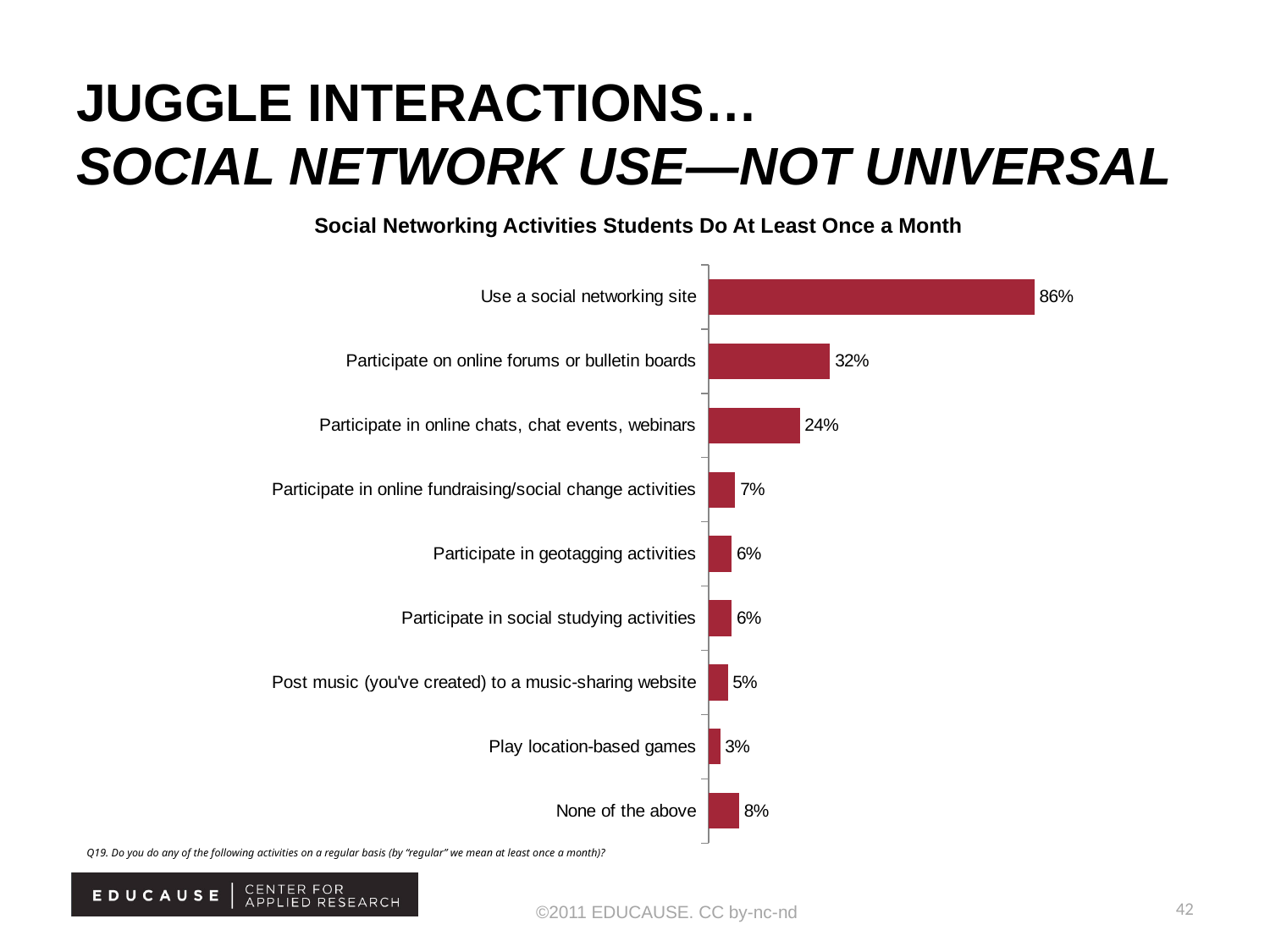
Which activity has the lowest percentage? Play location-based games How many activity categories are shown in the chart? 9 What is the title of the chart? Social Networking Activities Students Do At Least Once a Month Which is larger: 'None of the above' or 'Post music (you've created) to a music-sharing website'? None of the above What percentage of students use a social networking site at least once a month? 86% What percentage of students play location-based games at least once a month? 3% What kind of chart is shown on the slide? Bar chart What is the value for 'None of the above'? 8% What is the difference between 'Participate in online chats, chat events, webinars' and 'Participate in online fundraising/social change activities'? 17% What is the difference between 'Use a social networking site' and 'Participate on online forums or bulletin boards'? 54% What is the value for 'Participate on online forums or bulletin boards'? 32% Which activity has the highest percentage? Use a social networking site